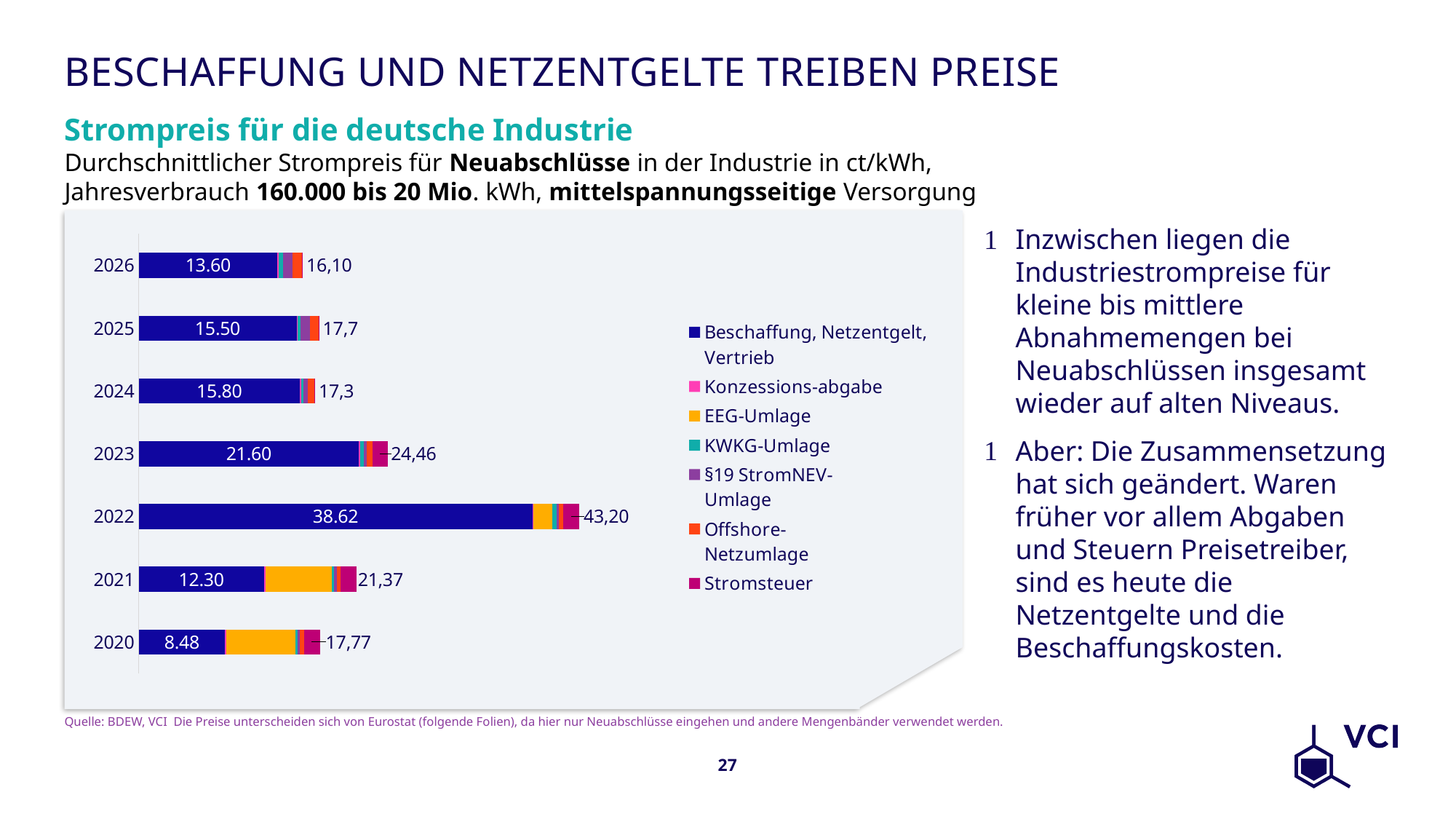
How many years are shown on the chart? 7 What is the total electricity price shown for 2026? 16,10 Which year has the highest total electricity price? 2022 Which year has the lowest value for the Beschaffung, Netzentgelt, Vertrieb segment? 2020 How many series does the legend list? 7 Which legend entry is shown in orange/yellow? EEG-Umlage What is the value of the Beschaffung, Netzentgelt, Vertrieb segment for 2022? 38.62 What kind of chart is shown on the slide? stacked bar chart What is the value of the Beschaffung, Netzentgelt, Vertrieb segment for 2021? 12.30 Is the total for 2023 larger or smaller than the total for 2021? larger What is the difference between the Beschaffung, Netzentgelt, Vertrieb values for 2024 and 2025? 0.30 What is the total electricity price shown for 2020? 17,77